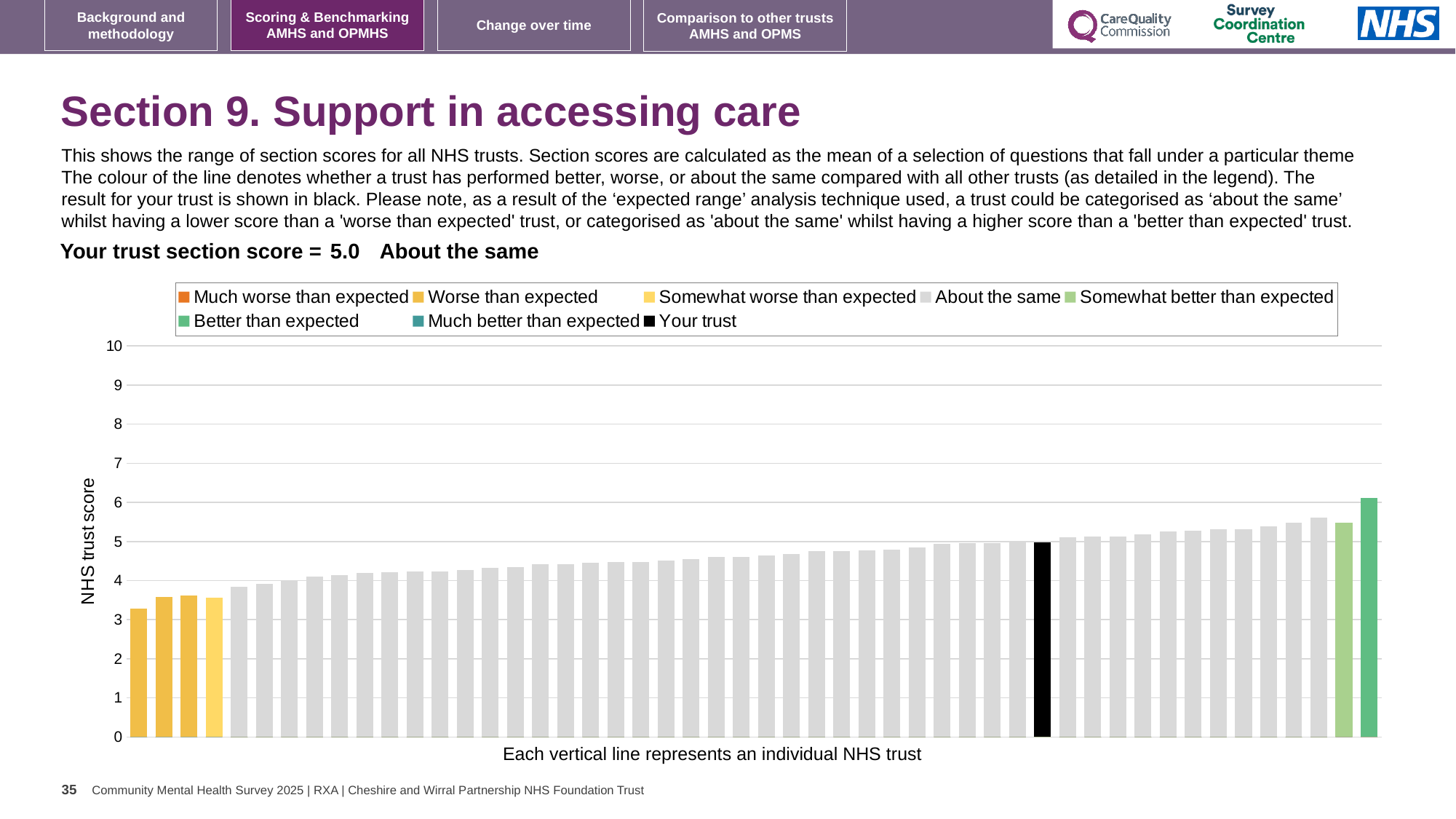
Is the value for your trust's bar greater or less than 4? greater How many entries does the chart legend list? 8 Is the value of the leftmost (lowest) bar greater or less than 4? less Is the value of the tallest bar greater or less than 5? greater What kind of chart is shown on the slide? bar chart What colour is the bar representing your trust? black Do the bar values rise or fall from left to right along the x axis? rise How many bars are coloured as 'Worse than expected'? 3 What is the label on the vertical axis? NHS trust score Which legend category does the tallest bar belong to? Better than expected Which legend category does your trust fall into? About the same What is the section score for your trust? 5.0